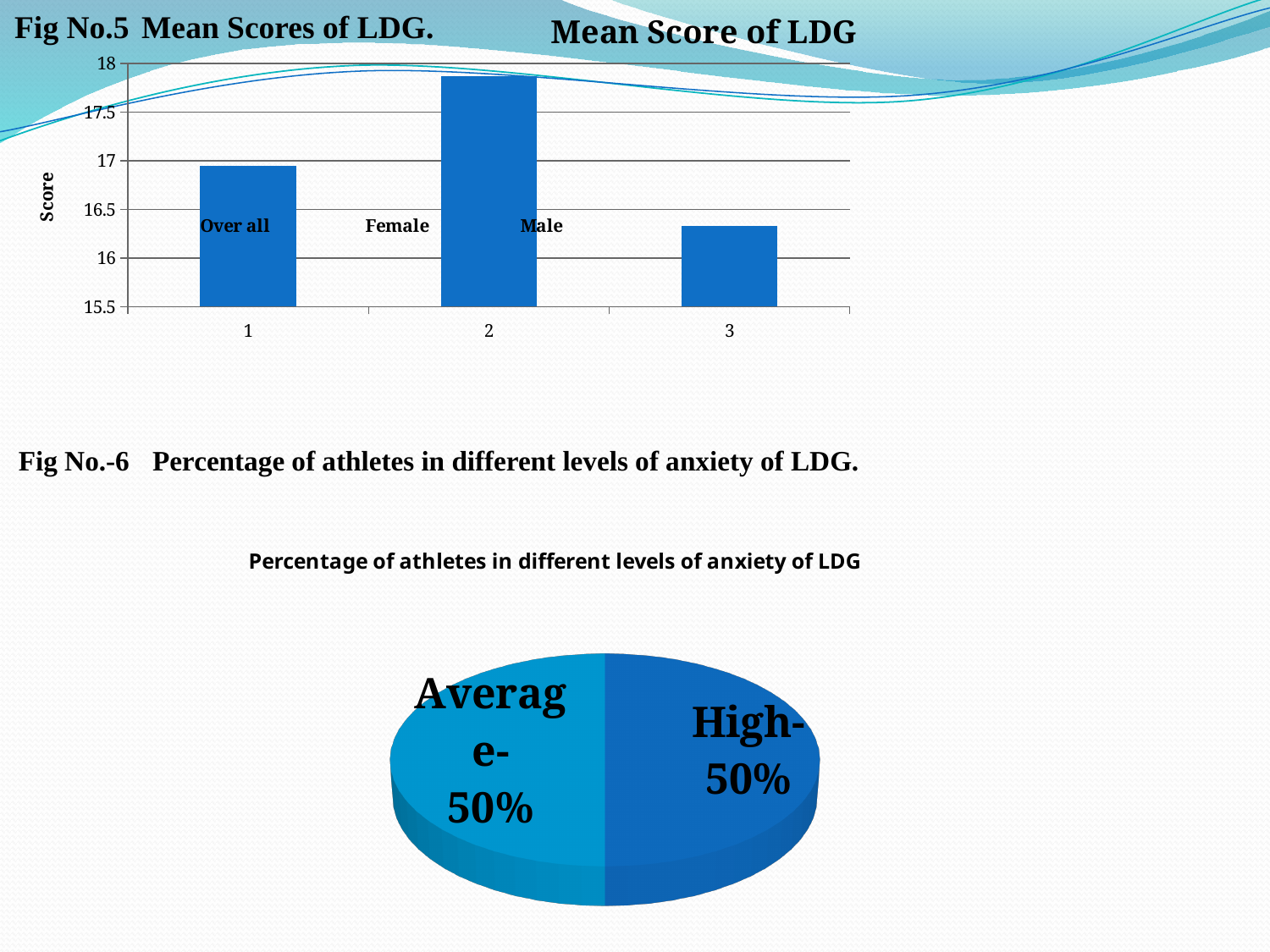
In the "Mean Score of LDG" chart, is the value for category 3 greater or less than 16.5? less In the "Mean Score of LDG" chart, which is larger, the bar for category 1 or the bar for category 3? 1 In the "Mean Score of LDG" chart, how many bars are plotted? 3 What kind of chart is "Percentage of athletes in different levels of anxiety of LDG"? pie chart In the "Mean Score of LDG" chart, what is the label on the vertical axis? Score What kind of chart is the "Mean Score of LDG" chart? bar chart In the "Mean Score of LDG" chart, which x-axis category has the highest bar? 2 In the "Mean Score of LDG" chart, is the value for category 2 greater or less than 17.5? greater In the "Percentage of athletes in different levels of anxiety of LDG" pie chart, how many slices are there? 2 In the "Percentage of athletes in different levels of anxiety of LDG" pie chart, what share does the High slice have? 50% In the "Mean Score of LDG" chart, is the value for category 1 greater or less than 16.5? greater In the "Mean Score of LDG" chart, which x-axis category has the lowest bar? 3